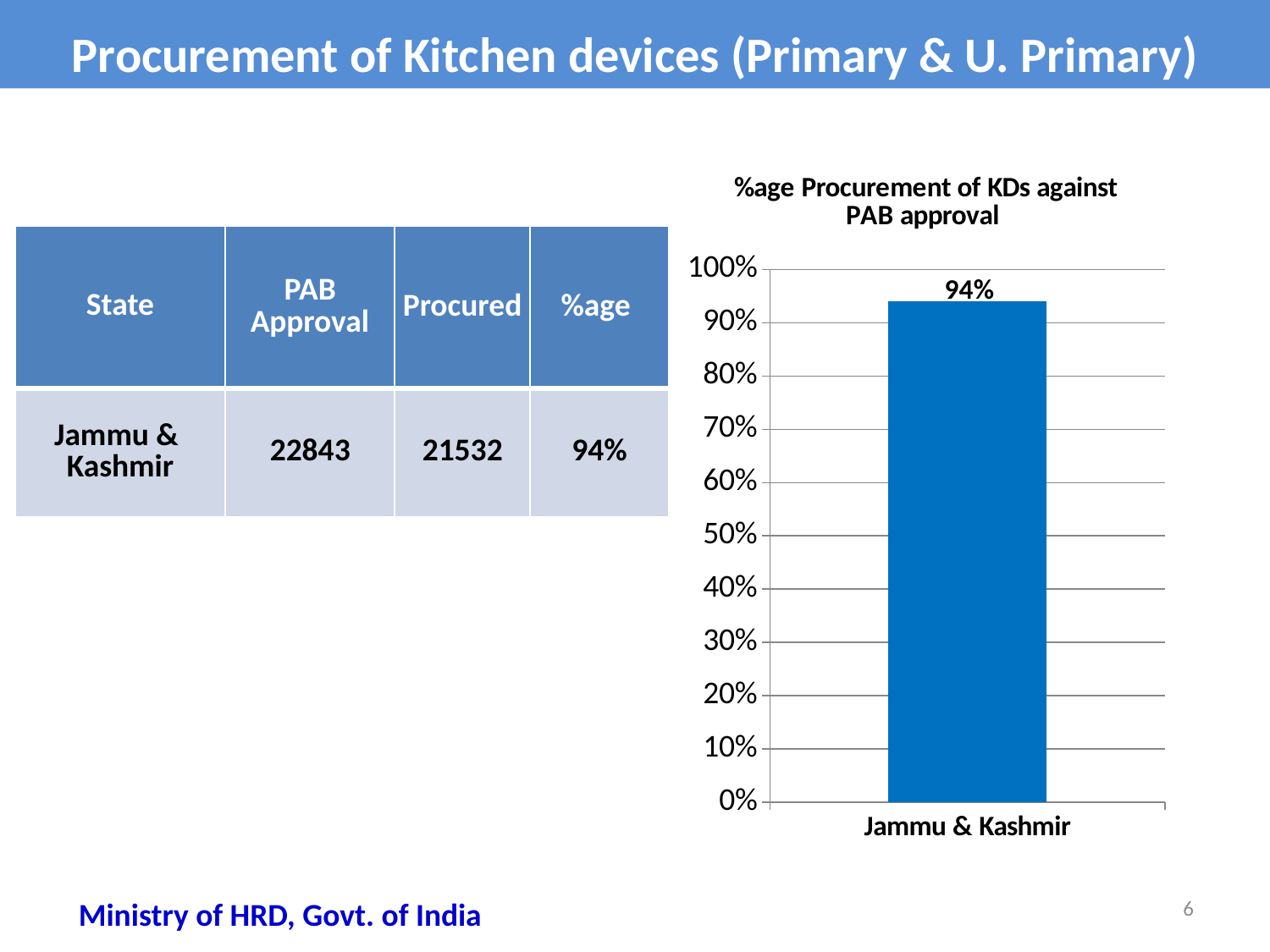
What is the title of the chart? %age Procurement of KDs against PAB approval What is the highest value shown on the chart's y axis? 100% Which category is shown on the x axis of the chart? Jammu & Kashmir How many categories are plotted in the chart? 1 Is the value for Jammu & Kashmir greater or less than 100%? less What kind of chart is shown on the slide? bar chart What is the value for Jammu & Kashmir in the chart? 94% Is the value for Jammu & Kashmir greater or less than 90%? greater